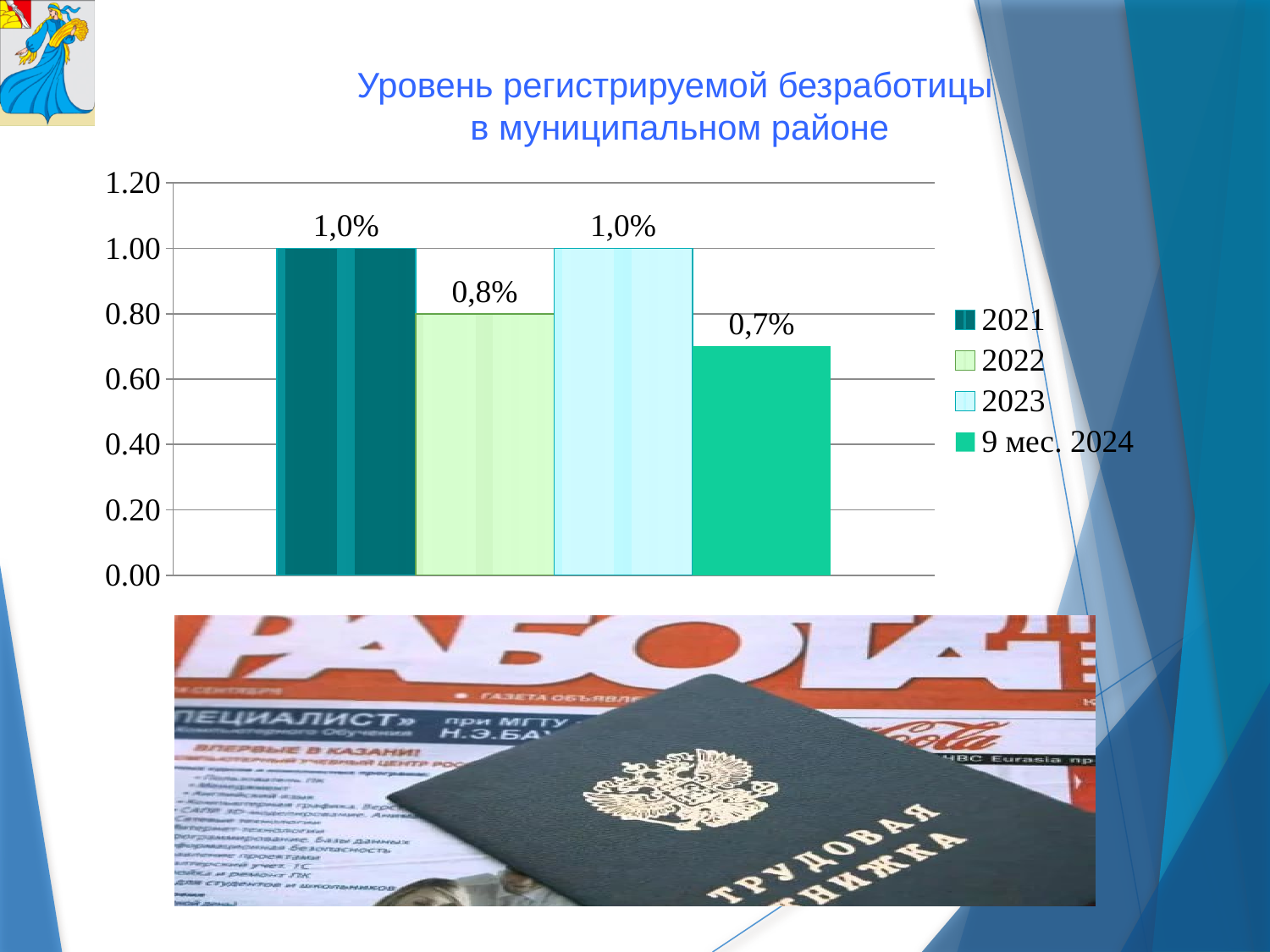
What is the difference between the values for 2022 and 9 мес. 2024? 0,1% What is the title of the chart? Уровень регистрируемой безработицы в муниципальном районе What is the value shown for 9 мес. 2024? 0,7% What is the value shown for 2021? 1,0% How many bars are plotted on the chart? 4 Which is larger, the value for 2021 or the value for 2022? 2021 What kind of chart is shown on the slide? bar chart Which period has the lowest value on the chart? 9 мес. 2024 Is the value for 9 мес. 2024 greater or less than 0.80? less What is the value shown for 2023? 1,0% What is the value shown for 2022? 0,8% How many entries does the legend list? 4